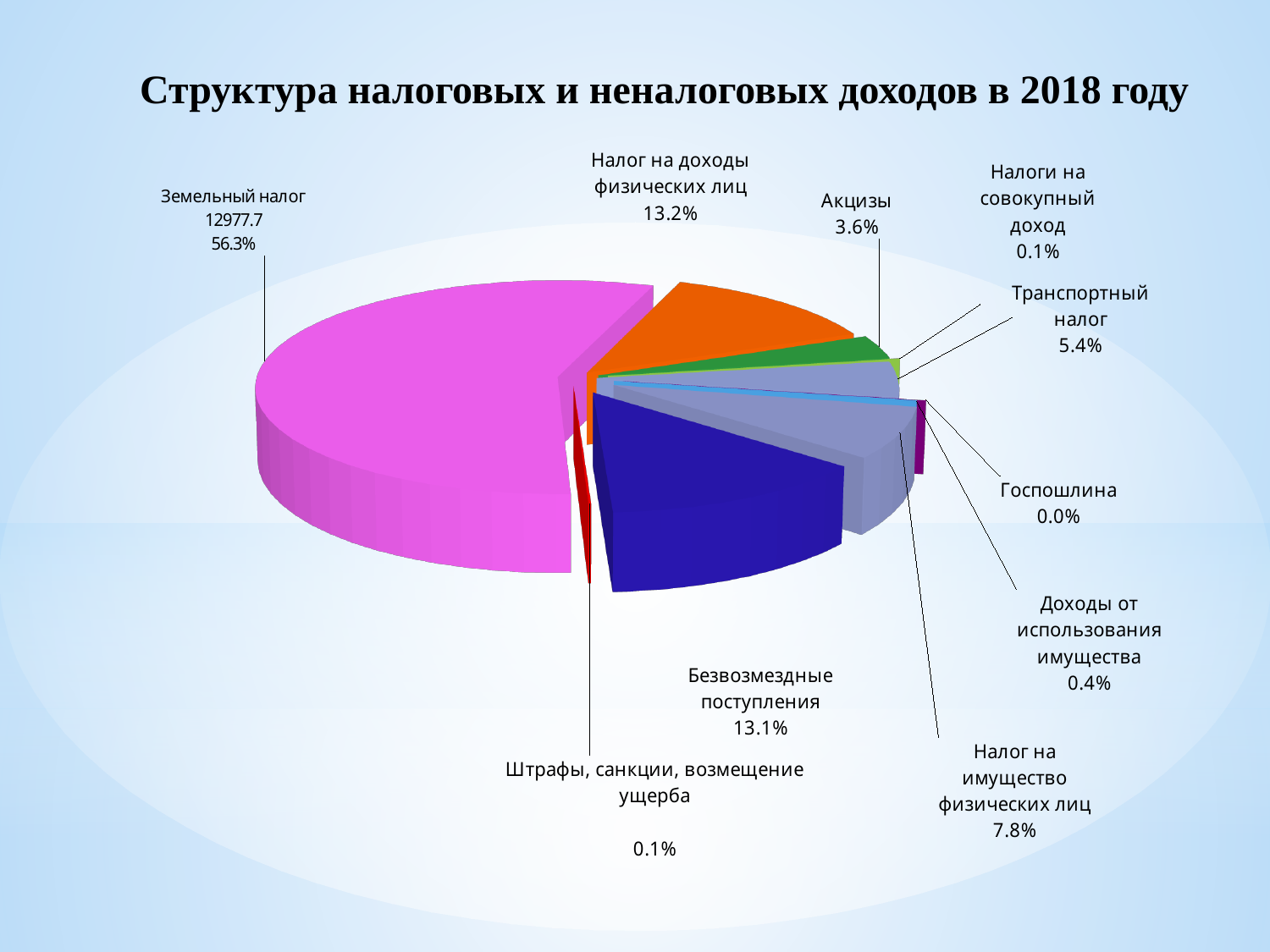
What percentage is shown for Налог на доходы физических лиц? 13.2% Which category has the smallest share of the pie? Госпошлина What is the difference in percentage points between Налог на доходы физических лиц and Налог на имущество физических лиц? 5.4 What value is printed for Земельный налог besides its percentage? 12977.7 What percentage is shown for Транспортный налог? 5.4% What is the title of the chart? Структура налоговых и неналоговых доходов в 2018 году What share of the pie does Земельный налог account for? 56.3% What kind of chart is shown on the slide? pie chart What percentage is shown for Налог на имущество физических лиц? 7.8% Which is larger: the share for Акцизы or the share for Транспортный налог? Транспортный налог Which category has the largest share of the pie? Земельный налог How many categories are shown in the pie chart? 10